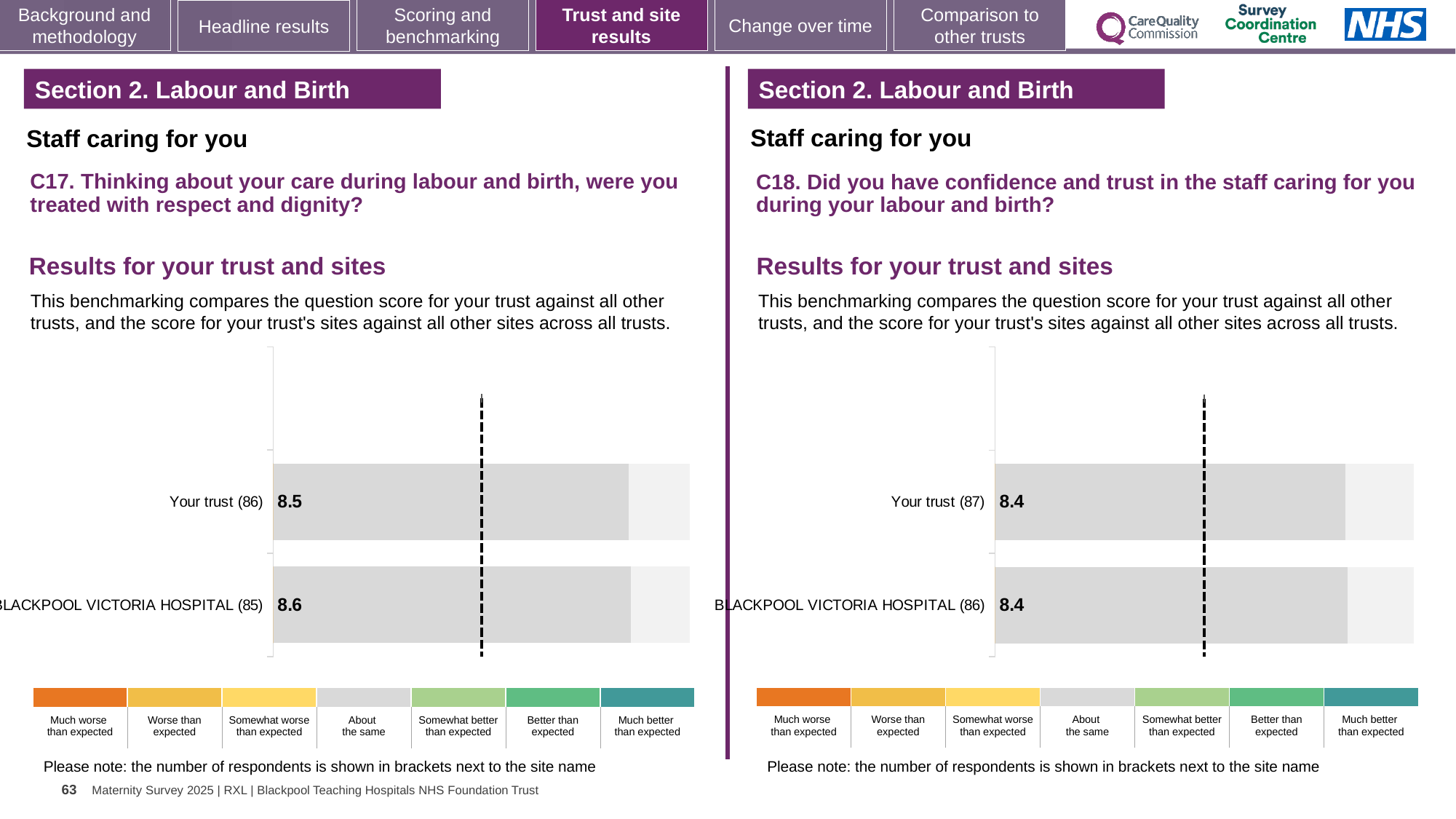
In the right chart (C18), what is the score for BLACKPOOL VICTORIA HOSPITAL (86)? 8.4 In the right chart (C18), what is the difference between the Your trust (87) score and the BLACKPOOL VICTORIA HOSPITAL (86) score? 0 How many bars are plotted in the left chart (C17)? 2 In the left chart (C17), what is the score for Your trust (86)? 8.5 In the left chart (C17), what is the score for BLACKPOOL VICTORIA HOSPITAL (85)? 8.6 In the right chart (C18), how many respondents are shown in brackets for BLACKPOOL VICTORIA HOSPITAL? 86 What type of chart is used on the left (C17)? Bar chart In the left chart (C17), what is the difference between the BLACKPOOL VICTORIA HOSPITAL (85) score and the Your trust (86) score? 0.1 How many bars are plotted in the right chart (C18)? 2 In the left chart (C17), which category has the higher score? BLACKPOOL VICTORIA HOSPITAL (85) In the right chart (C18), what is the score for Your trust (87)? 8.4 In the left chart (C17), how many respondents are shown in brackets for Your trust? 86